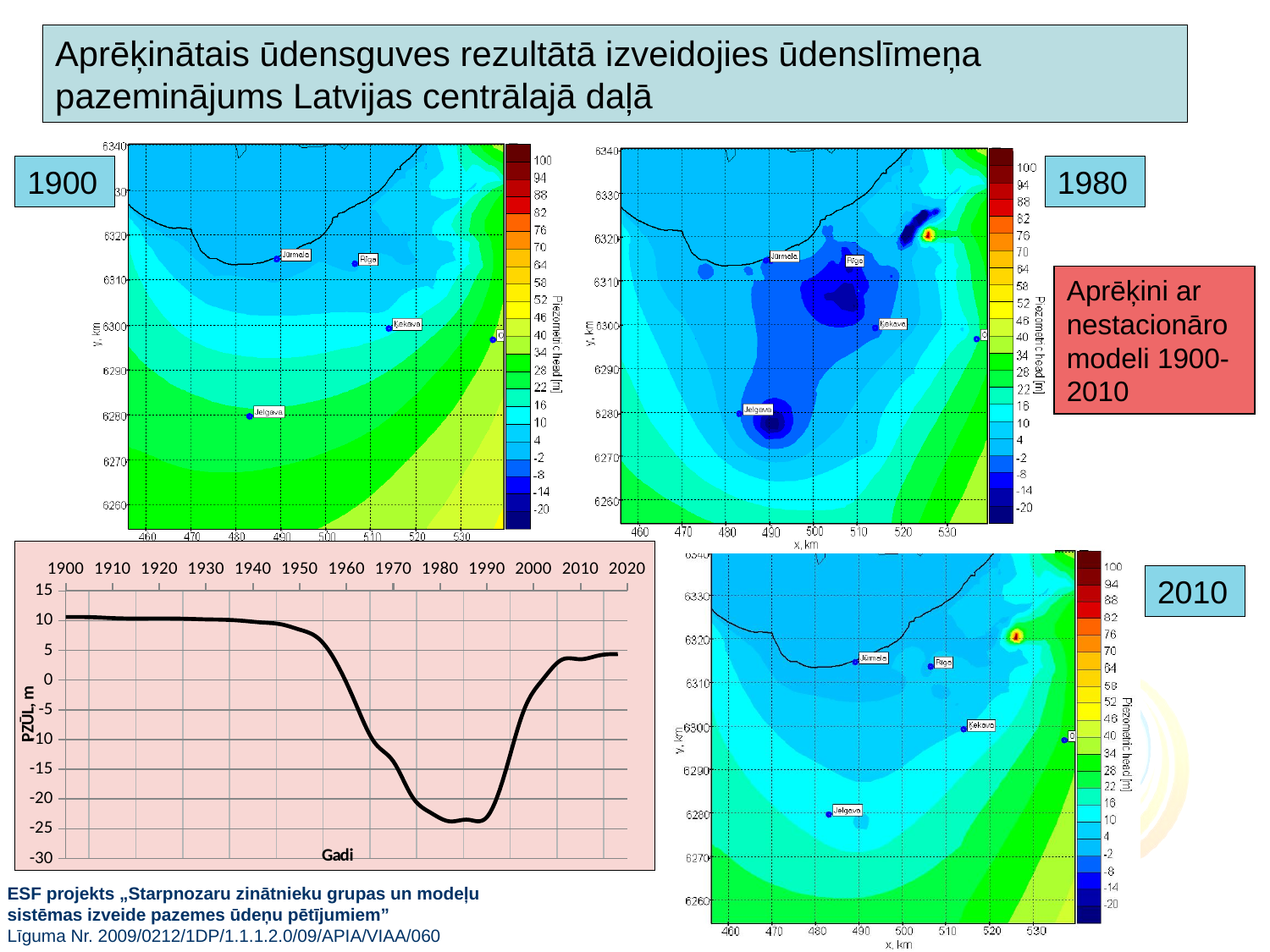
On the lower-left line chart, do the values rise or fall between 1990 and 2010? rise On the lower-left line chart, what is the label of the y axis? PZŪL, m On the lower-left line chart, is the value for 1900 greater or less than 5? greater On the lower-left line chart, is the value for 2010 greater or less than 0? greater On the lower-left line chart, do the values rise or fall between 1940 and 1980? fall How many contour maps are shown on the slide? 3 On the lower-left line chart, is the value for 1970 greater or less than 0? less What kind of chart is the chart in the lower left with axes 'Gadi' and 'PZŪL, m'? line chart On the lower-left line chart, what is the label of the x axis? Gadi On the lower-left line chart, how many year labels are shown along the x axis? 13 On the lower-left line chart, which is larger: the value for 1920 or the value for 1980? 1920